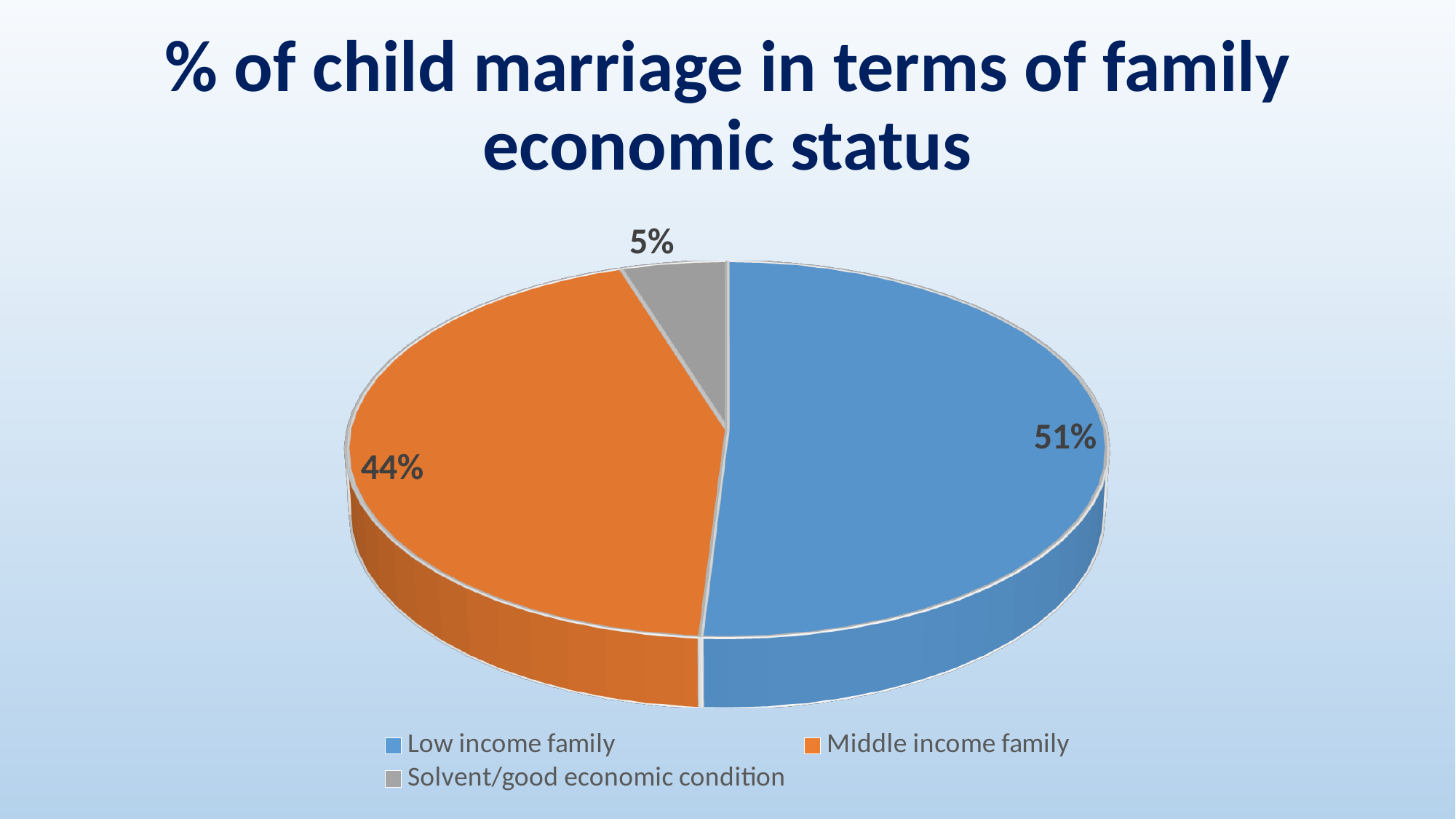
What is the title of the chart? % of child marriage in terms of family economic status What percentage of child marriage is attributed to middle income families? 44% What is the difference in percentage points between the middle income family share and the solvent/good economic condition share? 39 Which family economic status category has the largest share of child marriage? Low income family Which is larger: the share for low income family or the share for middle income family? Low income family How many categories are shown in the pie chart? 3 What percentage of child marriage is attributed to families with solvent/good economic condition? 5% Which family economic status category has the smallest share of child marriage? Solvent/good economic condition What percentage of child marriage is attributed to low income families? 51% What type of chart is shown on the slide? Pie chart Which colour represents the middle income family category in the pie chart? Orange What is the difference in percentage points between the low income family and middle income family shares? 7